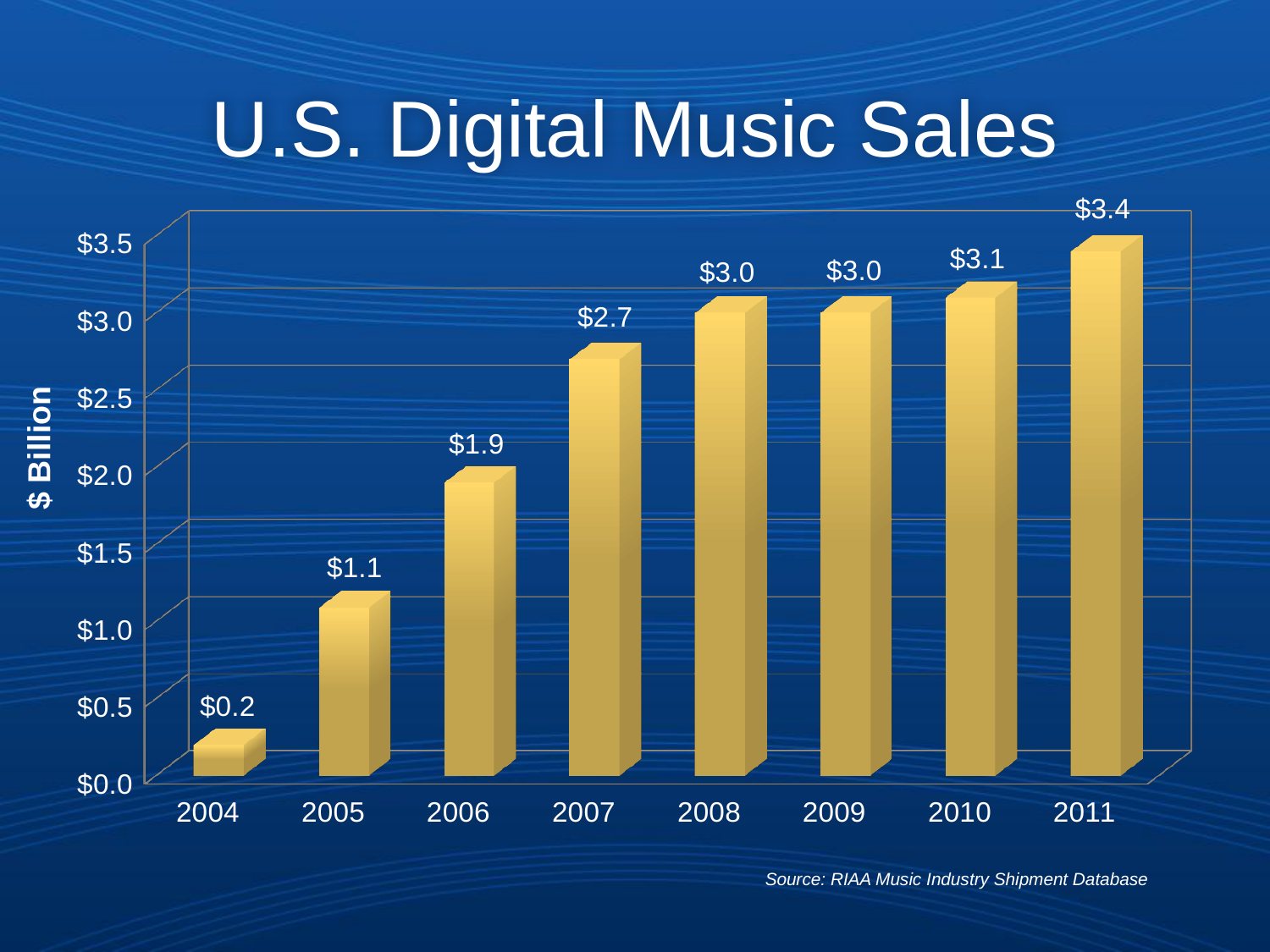
What is the difference between the values for 2011 and 2004? $3.2 Which year has the highest value? 2011 What is the value for 2004? $0.2 Which year has the lowest value? 2004 What kind of chart is shown on the slide? bar chart How many years are shown on the x axis? 8 What is the difference between the values for 2007 and 2006? $0.8 Is the value for 2010 greater or less than $2.5? greater What is the value for 2007? $2.7 Which is larger, the value for 2005 or the value for 2006? 2006 What is the value for 2011? $3.4 What is the title of the chart? U.S. Digital Music Sales